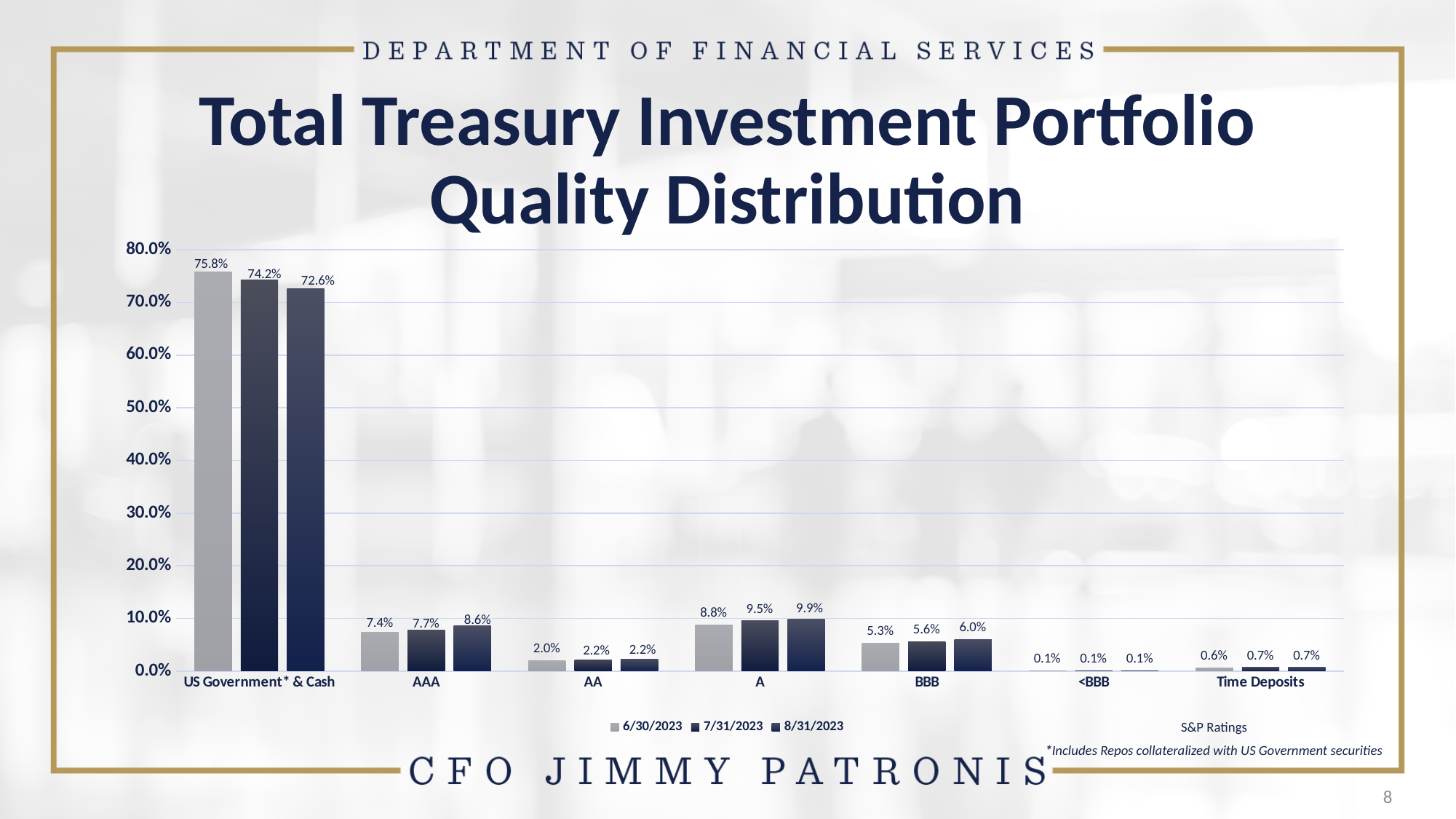
What is the value for Time Deposits in the 6/30/2023 series? 0.6% How many series does the legend list? 3 Does the value for US Government* & Cash rise or fall from 6/30/2023 to 8/31/2023? Fall What is the difference between the 6/30/2023 and 8/31/2023 values for US Government* & Cash? 3.2% How many categories are shown on the x axis? 7 What is the value for US Government* & Cash in the 6/30/2023 series? 75.8% Which category has the highest value in the 8/31/2023 series? US Government* & Cash What kind of chart is shown on the slide? Bar chart What is the value for AAA in the 8/31/2023 series? 8.6% What is the value for A in the 7/31/2023 series? 9.5% Which category has the lowest value in the 7/31/2023 series? <BBB Which is larger for BBB: the 6/30/2023 value or the 8/31/2023 value? 8/31/2023